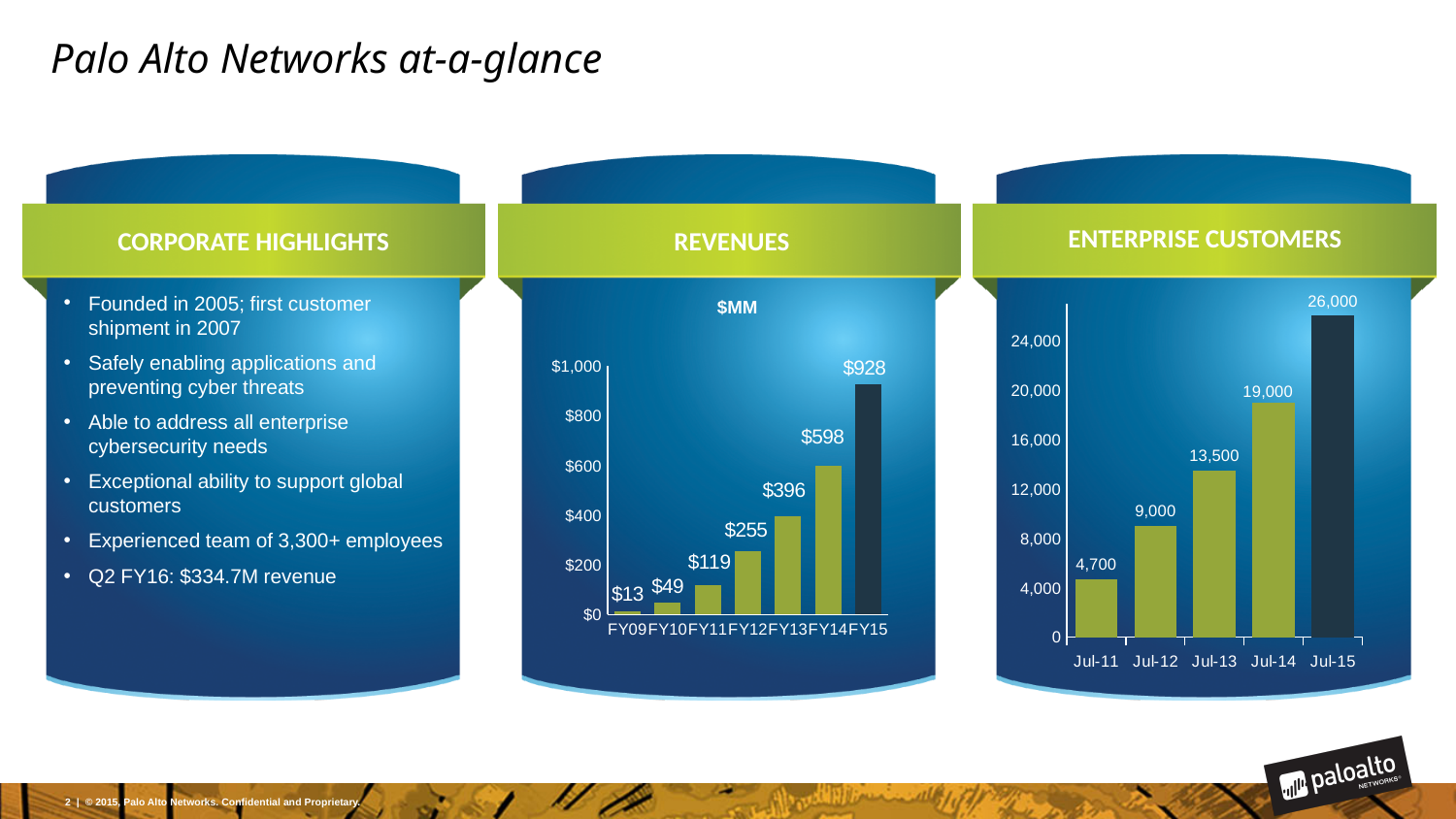
In the Revenues chart, what is the difference in revenue between FY15 and FY14? $330 In the Enterprise Customers chart, what is the difference in customers between Jul-15 and Jul-14? 7,000 In the Revenues chart, do revenues rise or fall from FY09 to FY15? rise In the Revenues chart, which fiscal year has the lowest revenue? FY09 In the Enterprise Customers chart, how many enterprise customers are shown for Jul-13? 13,500 In the Revenues chart, what is the revenue for FY15? $928 What unit label is shown above the Revenues chart? $MM In the Enterprise Customers chart, which is larger, the value for Jul-12 or Jul-11? Jul-12 In the Enterprise Customers chart, which period has the highest number of enterprise customers? Jul-15 In the Revenues chart, how many fiscal years are plotted? 7 What kind of chart is the Enterprise Customers chart? bar chart In the Revenues chart, what is the revenue for FY12? $255